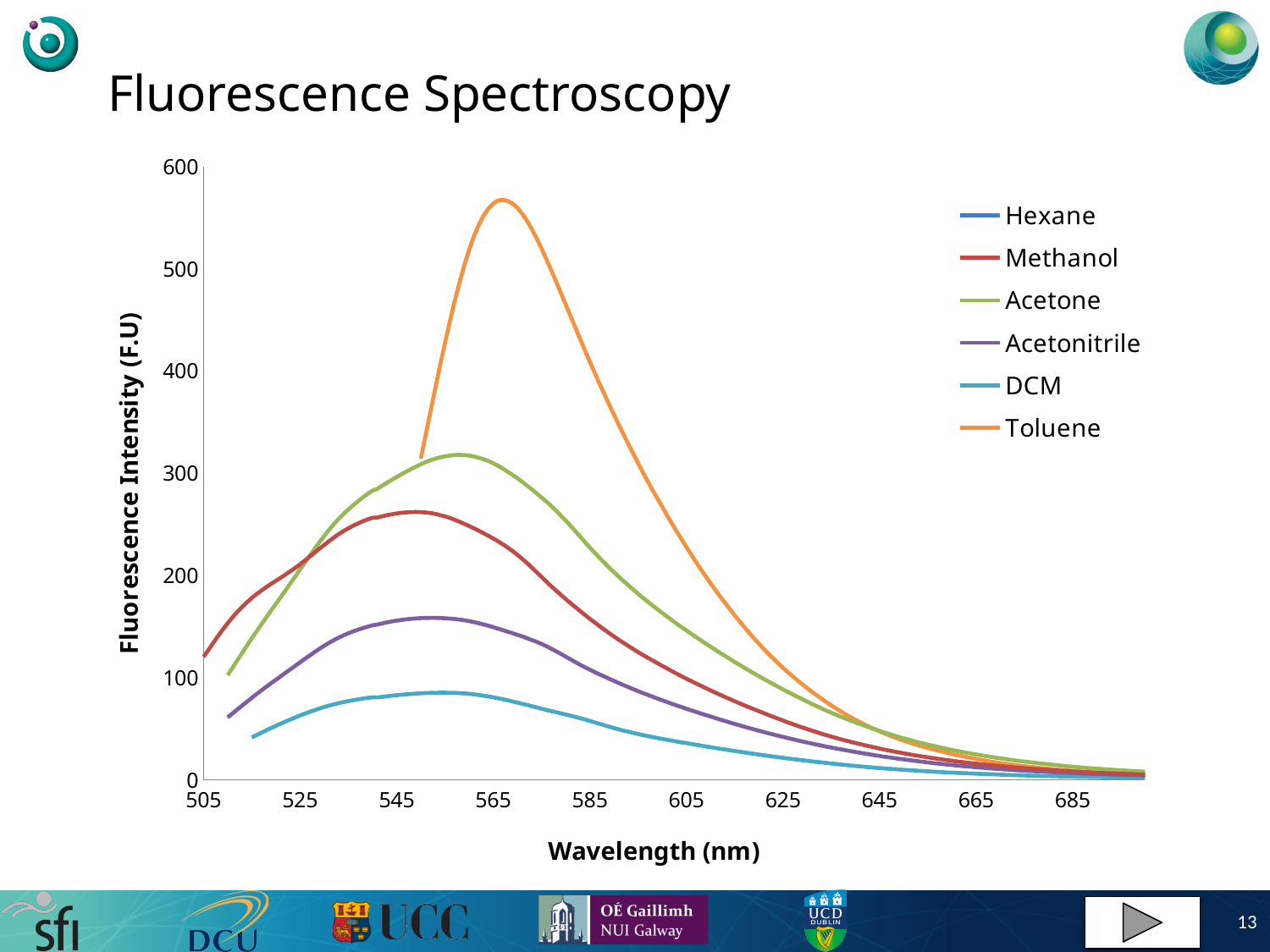
Which solvent reaches the highest fluorescence intensity? Toluene Which has the higher peak fluorescence intensity, Acetonitrile or DCM? Acetonitrile Is the peak fluorescence intensity for Acetonitrile greater or less than 200? less How many series does the legend list? 6 Do the fluorescence intensity curves rise or fall as wavelength increases from 605 nm to 685 nm? fall Is the peak fluorescence intensity for Toluene greater or less than 500? greater Is the peak fluorescence intensity for Methanol greater or less than 300? less What kind of chart is shown on the slide? line chart Which has the higher peak fluorescence intensity, Acetone or Methanol? Acetone What is the label of the x axis? Wavelength (nm)